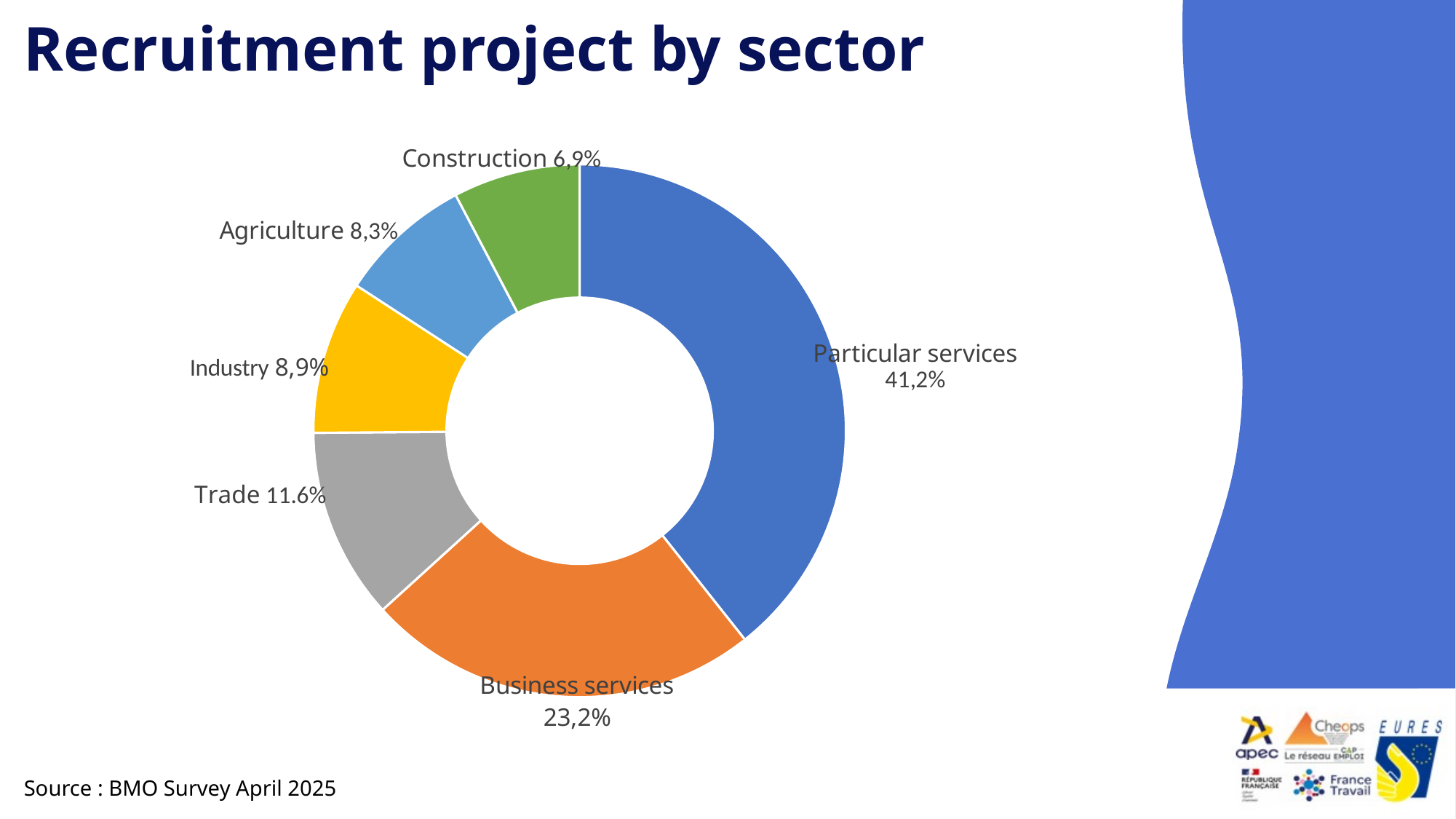
What is the value shown for Construction? 6,9% Which is larger, the share for Industry or the share for Agriculture? Industry How many sectors are shown in the chart? 6 What is the title of the chart? Recruitment project by sector What share of recruitment projects is attributed to Particular services? 41,2% Which sector has the smallest share of recruitment projects? Construction What is the value shown for Business services? 23,2% Which sector has the largest share of recruitment projects? Particular services What is the difference between the shares of Particular services and Business services? 18,0% What is the value shown for Trade? 11.6% What kind of chart is shown on the slide? doughnut chart What is the difference between the shares of Industry and Agriculture? 0,6%